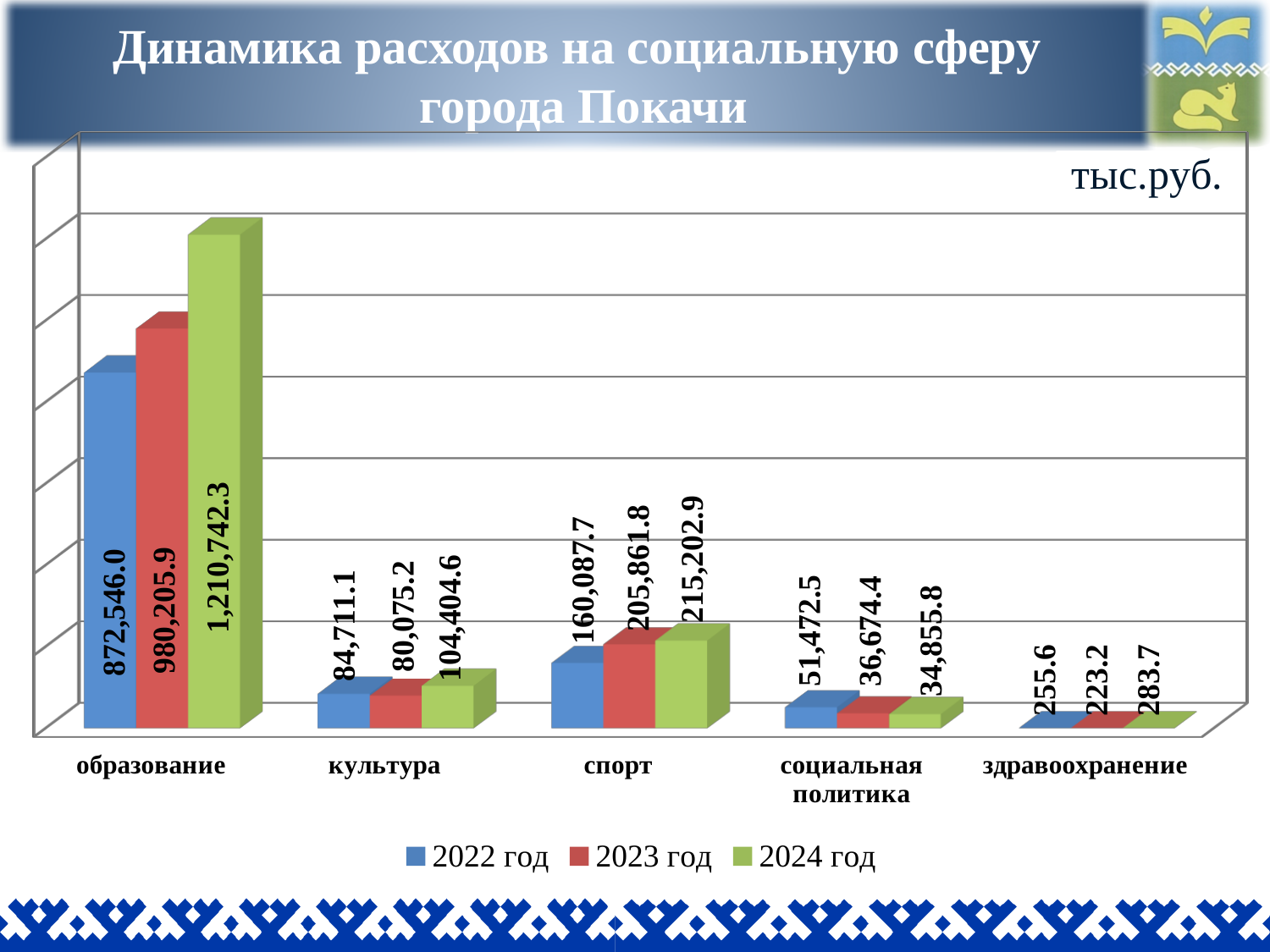
How many categories are shown on the x axis? 5 Which category has the lowest value in 2023 год? здравоохранение What is the value for здравоохранение in 2022 год? 255.6 Which is larger for культура: the 2022 год value or the 2023 год value? 2022 год What kind of chart is shown on the slide? bar chart How many series does the legend list? 3 Do the values for социальная политика rise or fall from 2022 год to 2024 год? fall What is the difference between the 2024 год and 2022 год values for образование? 338,196.3 What is the value for образование in 2024 год? 1,210,742.3 Which category has the highest value in 2024 год? образование What is the difference between the 2023 год and 2022 год values for спорт? 45,774.1 What is the value for спорт in 2023 год? 205,861.8